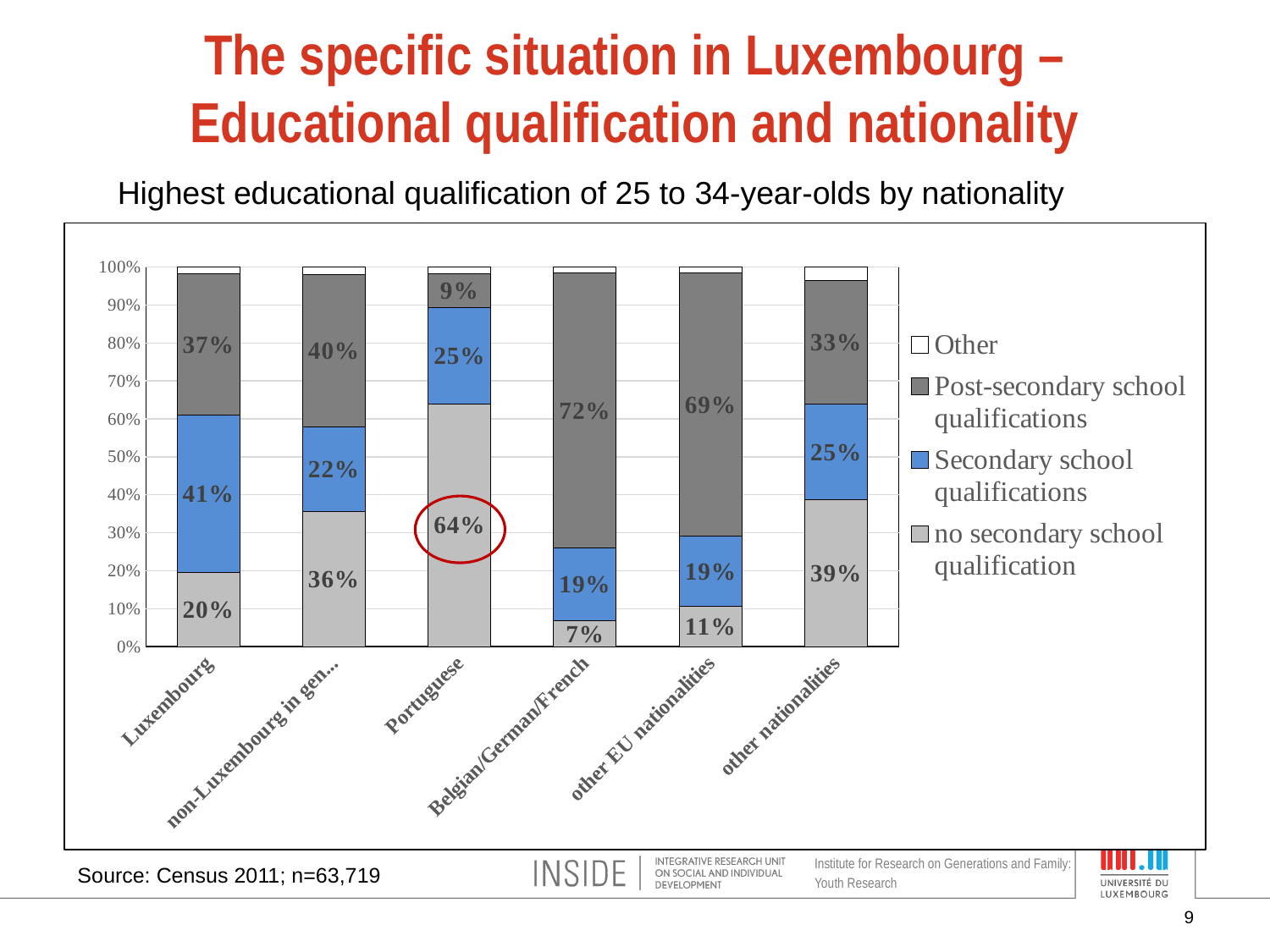
Which has a larger share of post-secondary school qualifications: other EU nationalities or other nationalities? other EU nationalities How many series does the legend list? 4 What is the share of post-secondary school qualifications for the Belgian/German/French group? 72% What percentage of the 'other EU nationalities' group has no secondary school qualification? 11% How many nationality groups are shown on the x axis? 6 What percentage of Portuguese 25 to 34-year-olds have no secondary school qualification? 64% Which nationality group has the highest share of post-secondary school qualifications? Belgian/German/French How many percentage points higher is the secondary school qualifications share for Luxembourg than for Portuguese? 16 percentage points Which nationality group has the highest share with no secondary school qualification? Portuguese What is the post-secondary school qualifications value for the Luxembourg group? 37% Which nationality group has the lowest share with no secondary school qualification? Belgian/German/French What kind of chart is shown on the slide? Stacked bar chart